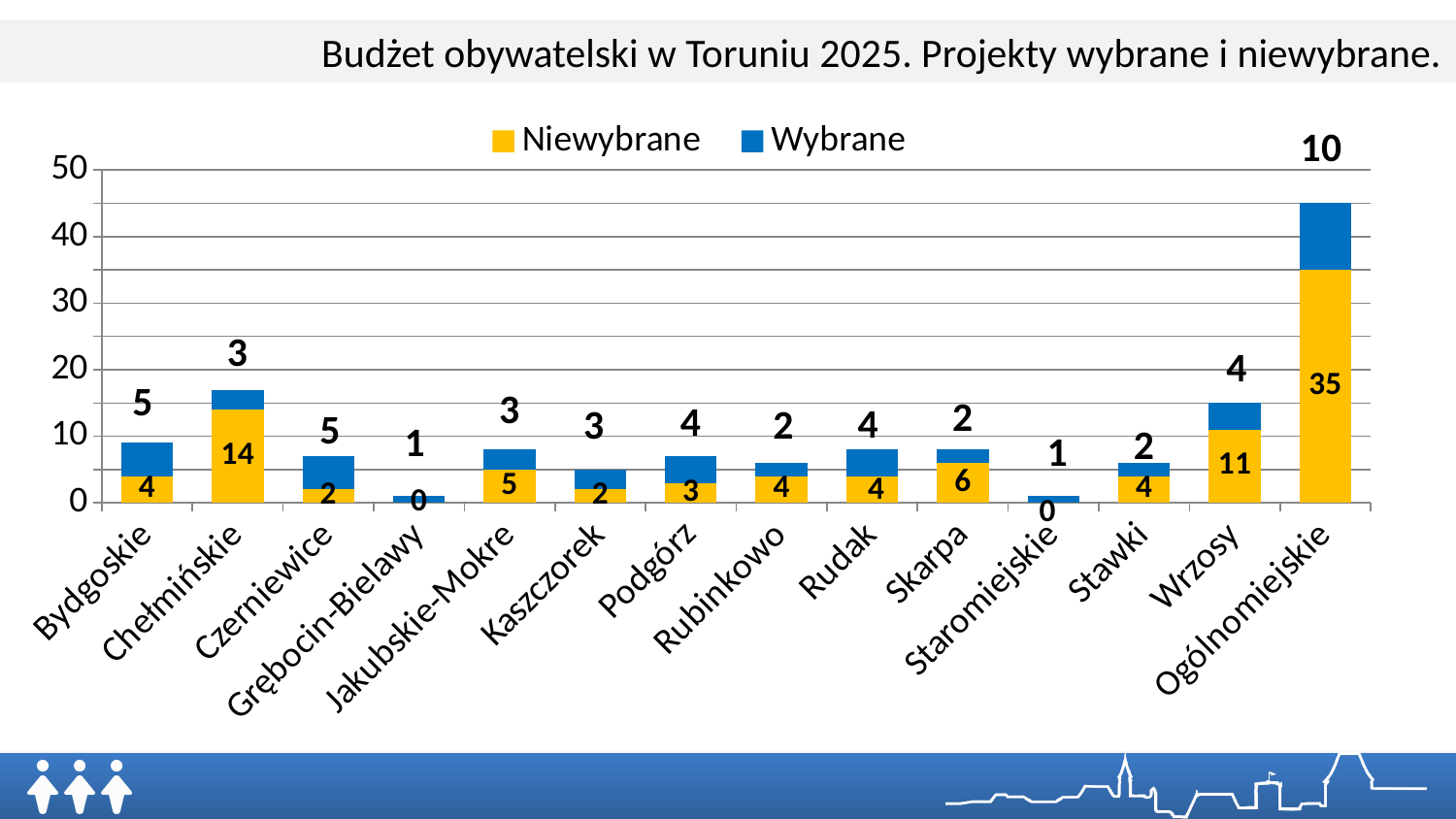
What is the total of the stacked bar for Ogólnomiejskie? 45 What is the difference between the Niewybrane values for Ogólnomiejskie and Wrzosy? 24 How many categories are shown on the x axis? 14 What is the total of the stacked bar for Chełmińskie? 17 How many series does the legend list? 2 What is the Niewybrane value for Wrzosy? 11 What is the title of the chart? Budżet obywatelski w Toruniu 2025. Projekty wybrane i niewybrane. Which is larger, the Wybrane value for Bydgoskie or the Wybrane value for Rubinkowo? Bydgoskie What is the Niewybrane value for Chełmińskie? 14 What type of chart is shown on the slide? stacked bar chart What is the Wybrane value for Ogólnomiejskie? 10 Which category has the highest Niewybrane value? Ogólnomiejskie